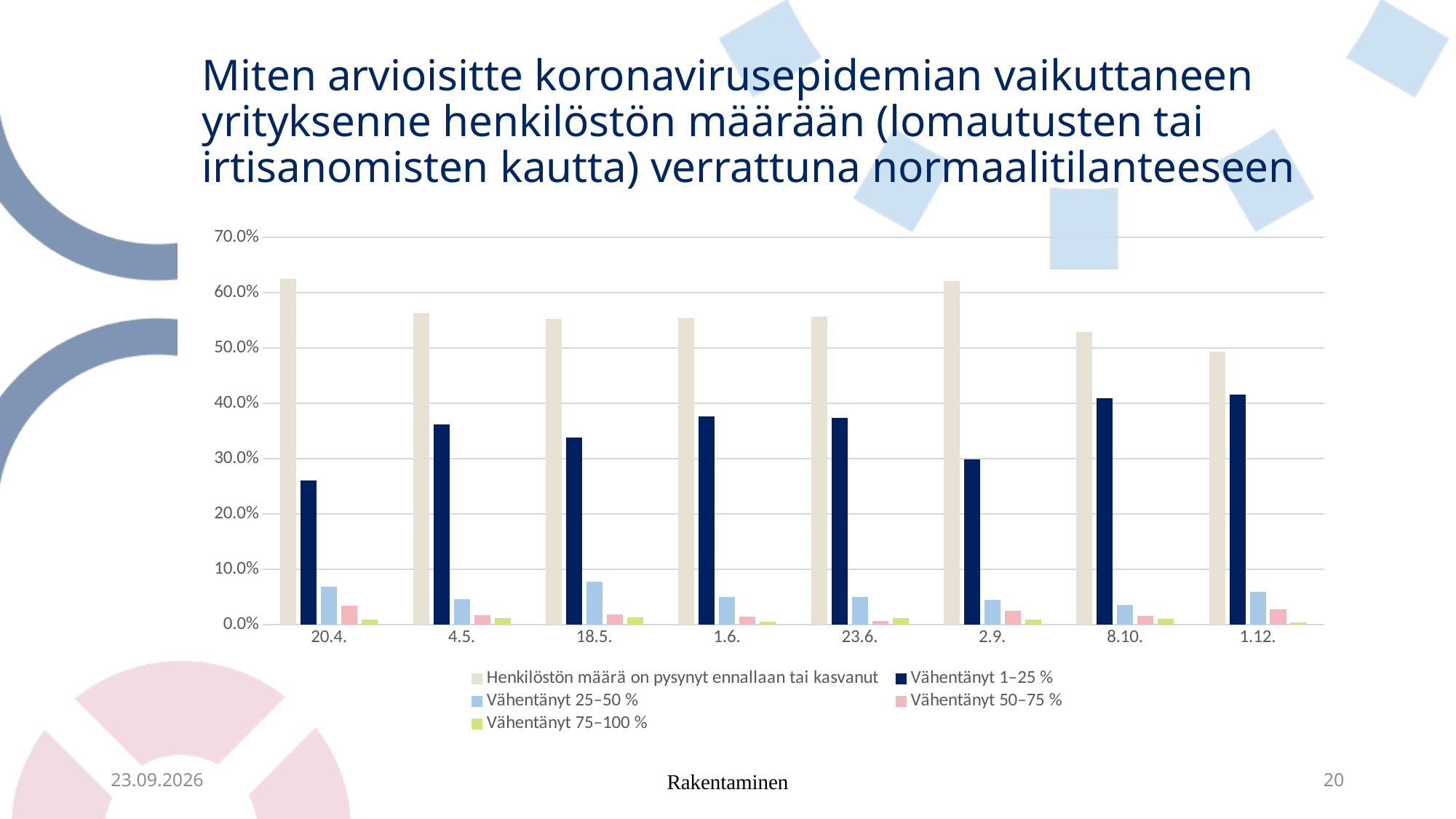
At which date is the value for 'Henkilöstön määrä on pysynyt ennallaan tai kasvanut' lowest? 1.12. Is the value for 'Henkilöstön määrä on pysynyt ennallaan tai kasvanut' at 20.4. greater or less than 60.0%? greater At 1.12., which is larger: 'Henkilöstön määrä on pysynyt ennallaan tai kasvanut' or 'Vähentänyt 1–25 %'? Henkilöstön määrä on pysynyt ennallaan tai kasvanut How many series does the legend list? 5 Is the value for 'Vähentänyt 1–25 %' at 8.10. greater or less than 40.0%? greater For 'Vähentänyt 1–25 %', which date has the larger value: 1.6. or 2.9.? 1.6. Is the value for 'Vähentänyt 25–50 %' at 18.5. greater or less than 10.0%? less How many dates (categories) are shown on the x axis? 8 At which date is the value for 'Vähentänyt 1–25 %' lowest? 20.4. What kind of chart is shown on the slide? bar chart